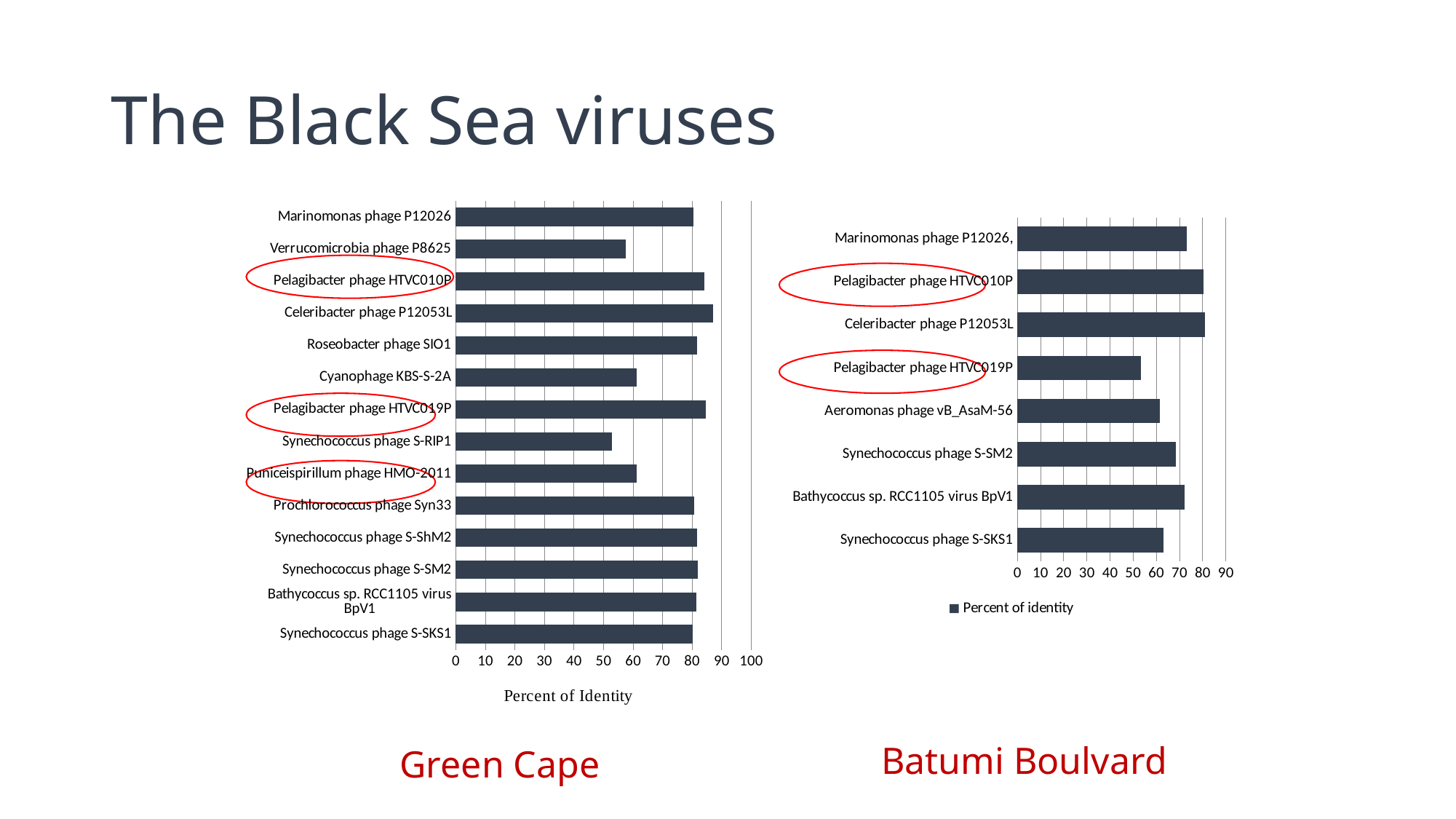
In the Green Cape chart, is the value for Verrucomicrobia phage P8625 greater or less than 70? less What kind of chart is the Green Cape chart? bar chart In the Green Cape chart, which is larger: the value for Marinomonas phage P12026 or Verrucomicrobia phage P8625? Marinomonas phage P12026 In the Batumi Boulvard chart, is the value for Pelagibacter phage HTVC019P greater or less than 60? less What is the x-axis title of the Green Cape chart? Percent of Identity In the Batumi Boulvard chart, which category has the lowest percent of identity? Pelagibacter phage HTVC019P How many series does the legend of the Batumi Boulvard chart list? 1 In the Green Cape chart, is the value for Celeribacter phage P12053L greater or less than 80? greater How many categories are plotted in the Batumi Boulvard chart? 8 In the Green Cape chart, which category has the lowest percent of identity? Synechococcus phage S-RIP1 How many categories are plotted in the Green Cape chart? 14